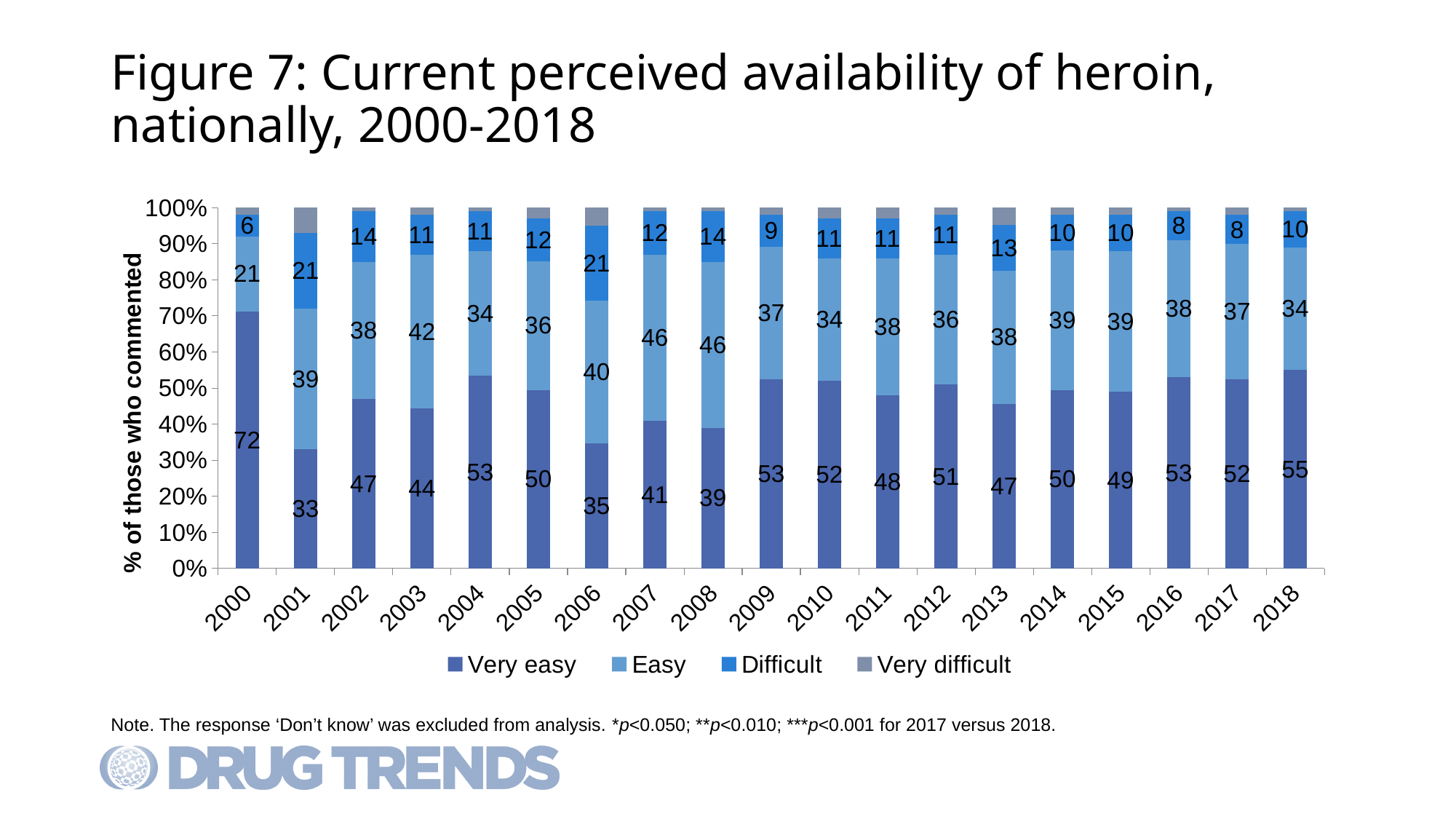
What is the 'Easy' value for 2007? 46 In which year was the 'Very easy' share lowest? 2001 How many years are shown on the x axis? 19 What kind of chart is shown on the slide? Stacked bar chart What percentage of respondents rated heroin as 'Very easy' to obtain in 2000? 72 What is the 'Difficult' value for 2013? 13 In which year was the 'Very easy' share highest? 2000 By how many percentage points did the 'Very easy' share change from 2017 to 2018? 3 How many series does the legend list? 4 What is the 'Very easy' value for 2018? 55 Which year had a larger 'Easy' share, 2003 or 2004? 2003 In which year was the 'Easy' share lowest? 2000